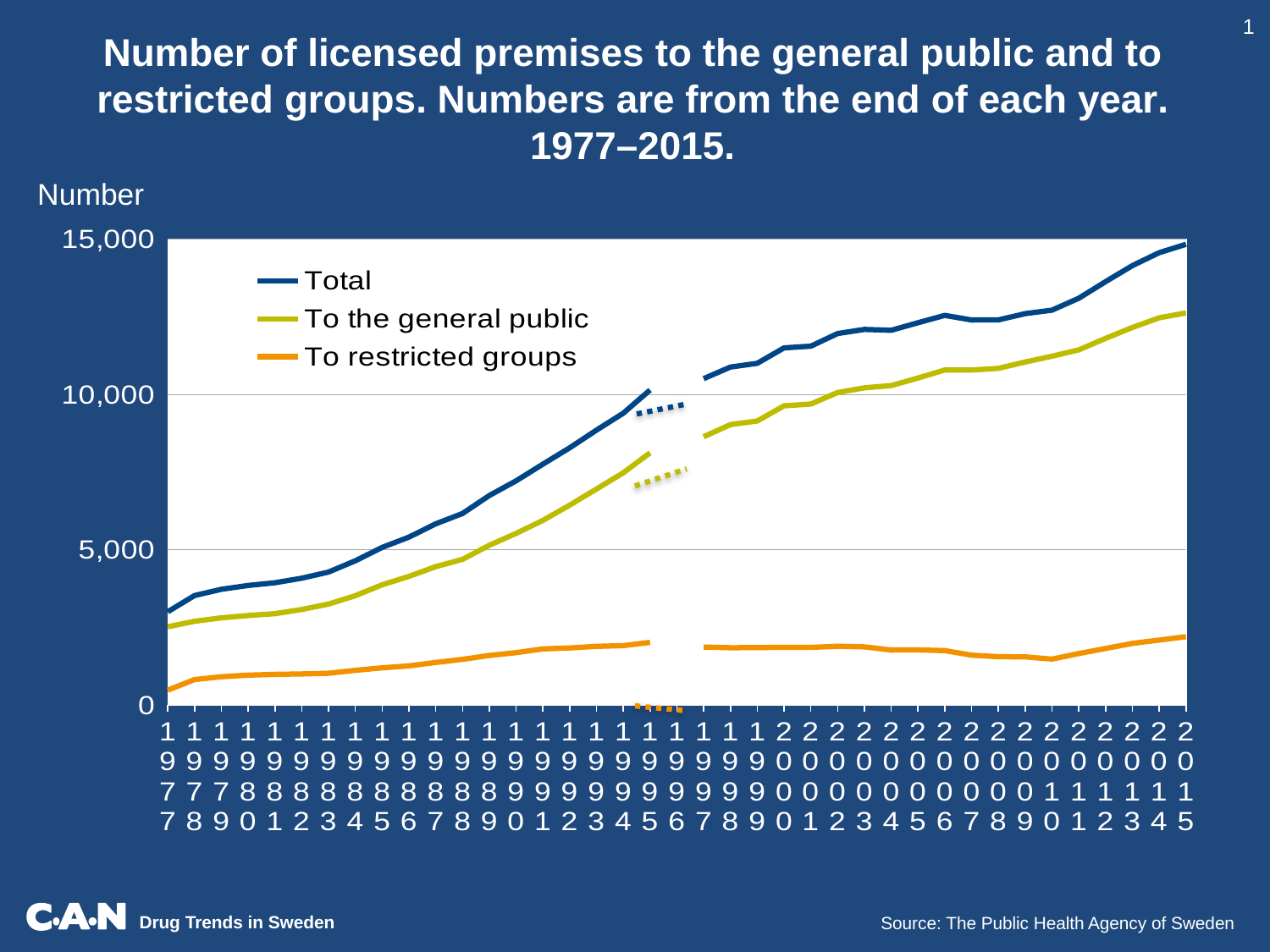
Which series has the highest values throughout the chart? Total Is the value for To the general public in 2015 greater or less than 10,000? greater Is the value for To restricted groups in 2015 greater or less than 5,000? less How many years are plotted along the x axis? 39 What label is shown on the y axis? Number How many series does the legend list? 3 In 2015, which is larger: the value for Total or the value for To restricted groups? Total Does the Total series rise or fall from 1977 to 2015? rise Is the value for Total in 2015 greater or less than 10,000? greater What kind of chart is shown on the slide? line chart Which series has the lowest values throughout the chart? To restricted groups